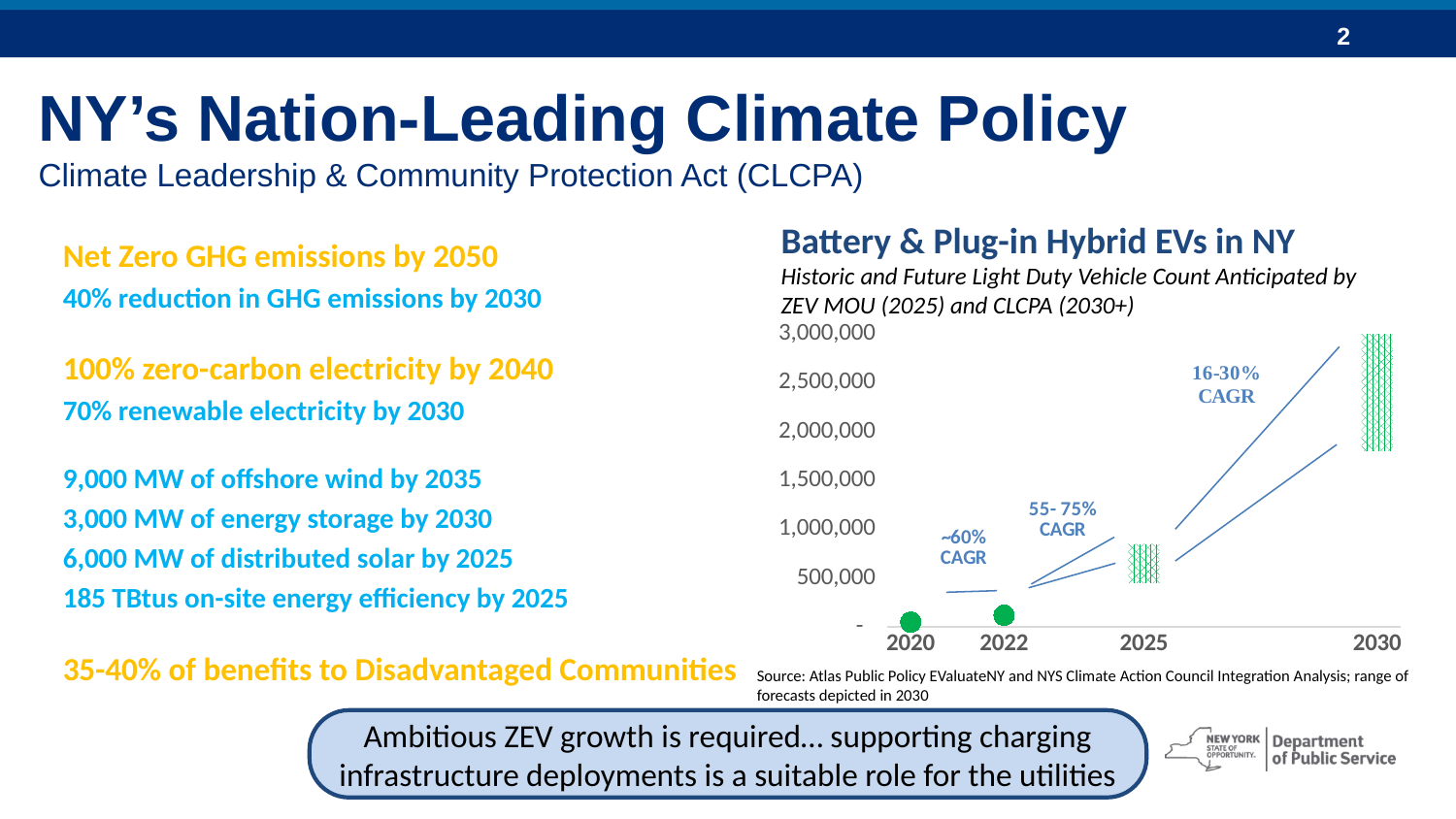
What CAGR is annotated on the chart between 2020 and 2022? ~60% CAGR Is the EV count for 2022 greater or less than 500,000? less What CAGR range is annotated on the chart between 2022 and 2025? 55-75% CAGR Which year shows the highest EV count in the chart? 2030 What CAGR range is annotated on the chart between 2025 and 2030? 16-30% CAGR Is the forecast EV count range for 2025 greater or less than 1,000,000? less What kind of chart is used to show Battery & Plug-in Hybrid EVs in NY? combination bar and line chart How many years are labeled on the x axis of the chart? 4 Is the EV count for 2020 greater or less than 500,000? less Do the EV counts in the chart rise or fall from 2020 to 2030? rise What is the title of the chart on the slide? Battery & Plug-in Hybrid EVs in NY